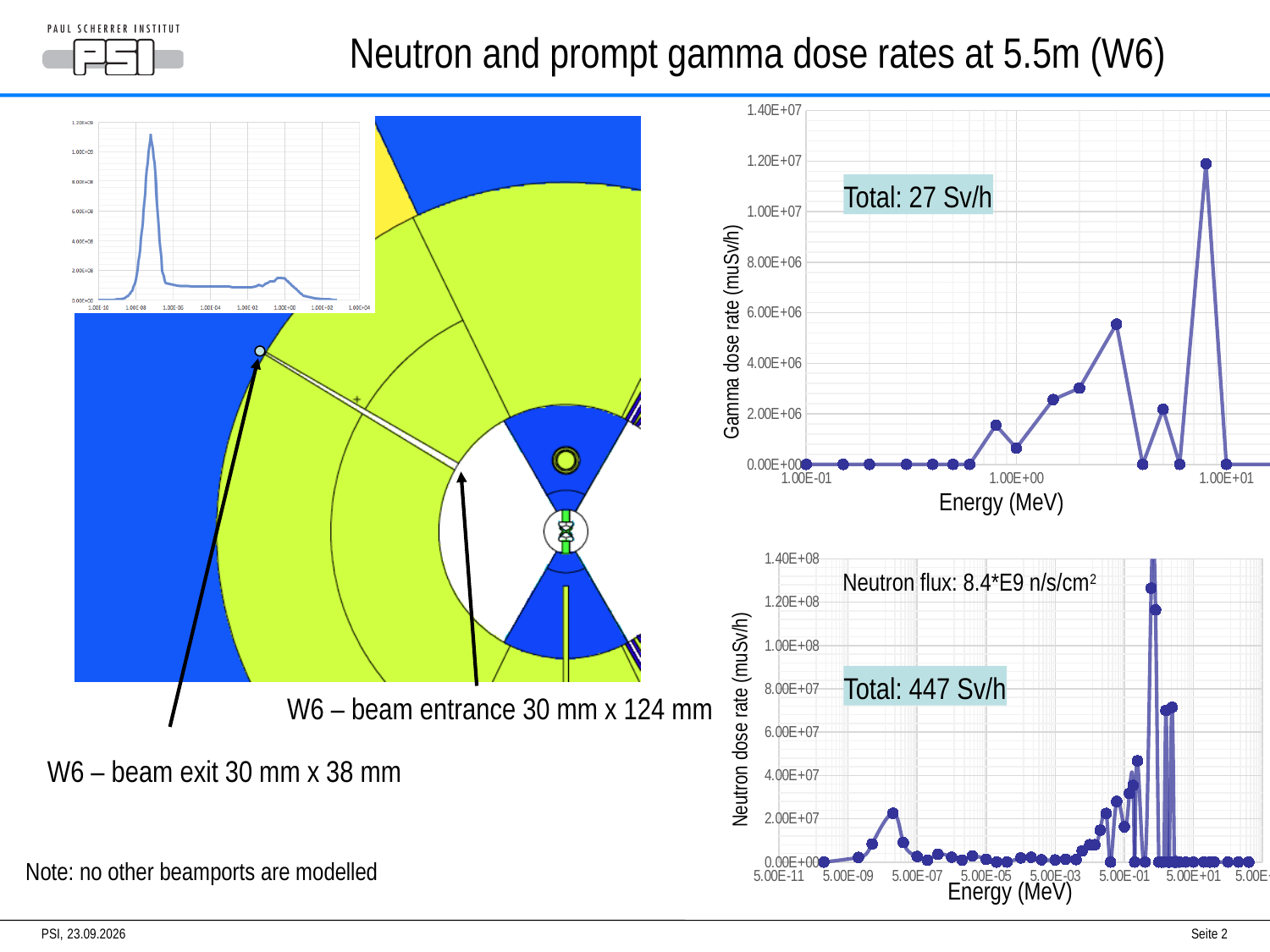
In the bottom-right neutron dose rate chart, what total dose rate is stated in the text box? 447 Sv/h In the bottom-right neutron dose rate chart, is the low-energy peak near 5.00E-08 MeV greater or less than 4.00E+07 muSv/h? less In the bottom-right neutron dose rate chart, what is the highest tick value shown on the y-axis? 1.40E+08 In the top-right gamma dose rate chart, what total dose rate is stated in the text box? 27 Sv/h In the bottom-right neutron dose rate chart, what neutron flux is stated? 8.4*E9 n/s/cm² What is the y-axis label of the top-right chart? Gamma dose rate (muSv/h) What is the difference between the total stated on the neutron dose rate chart and the total stated on the gamma dose rate chart? 420 Sv/h In the top-right gamma dose rate chart, is the highest plotted gamma dose rate greater or less than 1.00E+07 muSv/h? greater What kind of chart is the top-right chart of gamma dose rate versus energy? line chart Which is larger, the total stated on the gamma dose rate chart or the total stated on the neutron dose rate chart? neutron dose rate chart (447 Sv/h) What is the x-axis label of the bottom-right neutron dose rate chart? Energy (MeV) In the top-right gamma dose rate chart, is the gamma dose rate at 1.00E-01 MeV greater or less than 2.00E+06 muSv/h? less